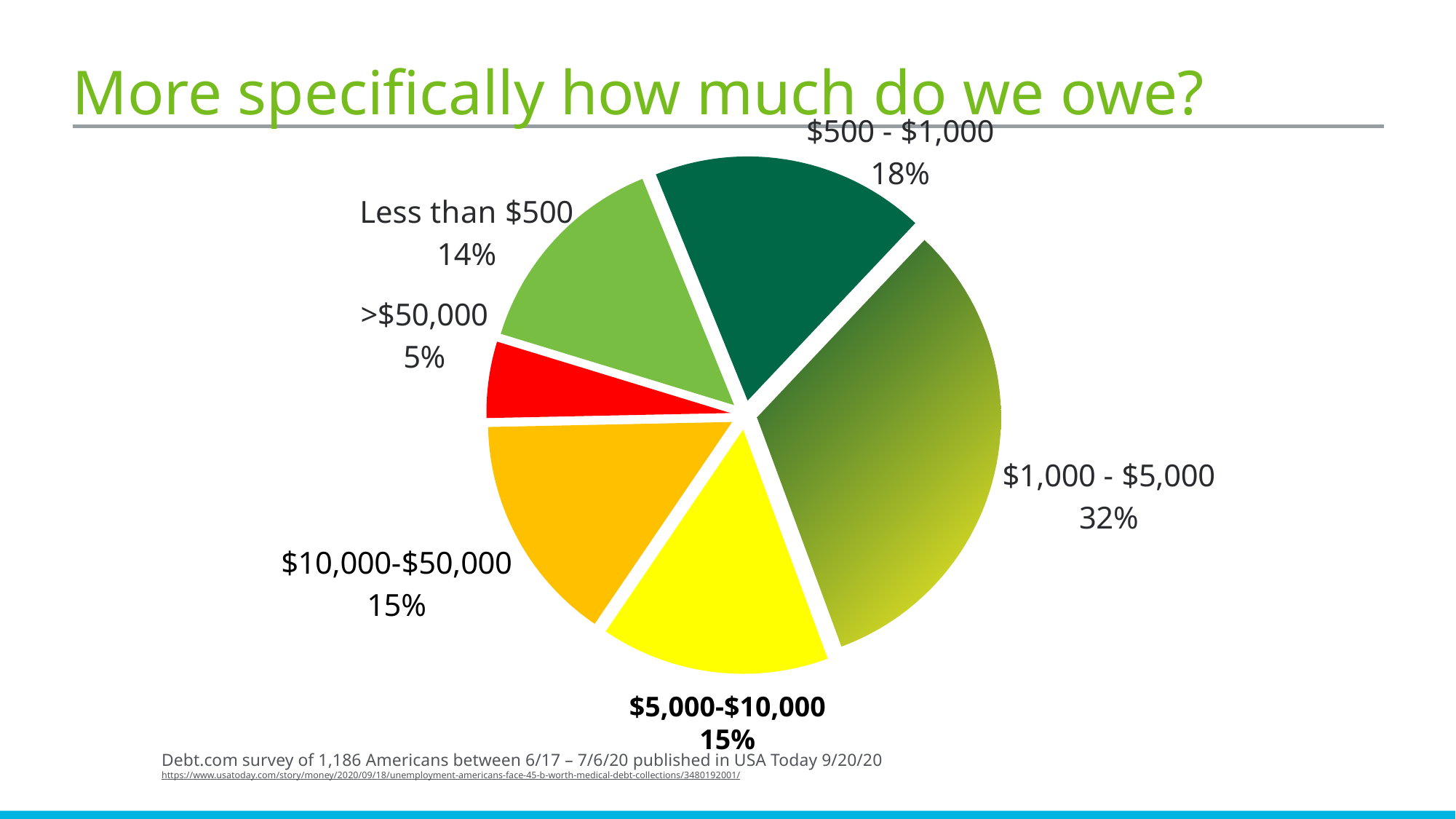
What colour is the >$50,000 slice? Red Which category has the smallest slice of the pie? >$50,000 Which slice is larger, Less than $500 or $500 - $1,000? $500 - $1,000 What share of the pie is the $1,000 - $5,000 slice? 32% How many slices does the pie chart have? 6 What is the combined share of the $5,000-$10,000 and $10,000-$50,000 slices? 30% What kind of chart is shown on the slide? Pie chart What percentage is shown for the >$50,000 slice? 5% What percentage is shown for the Less than $500 slice? 14% What percentage is shown for the $500 - $1,000 slice? 18% What is the difference in percentage points between the $1,000 - $5,000 slice and the $500 - $1,000 slice? 14 Which category has the largest slice of the pie? $1,000 - $5,000